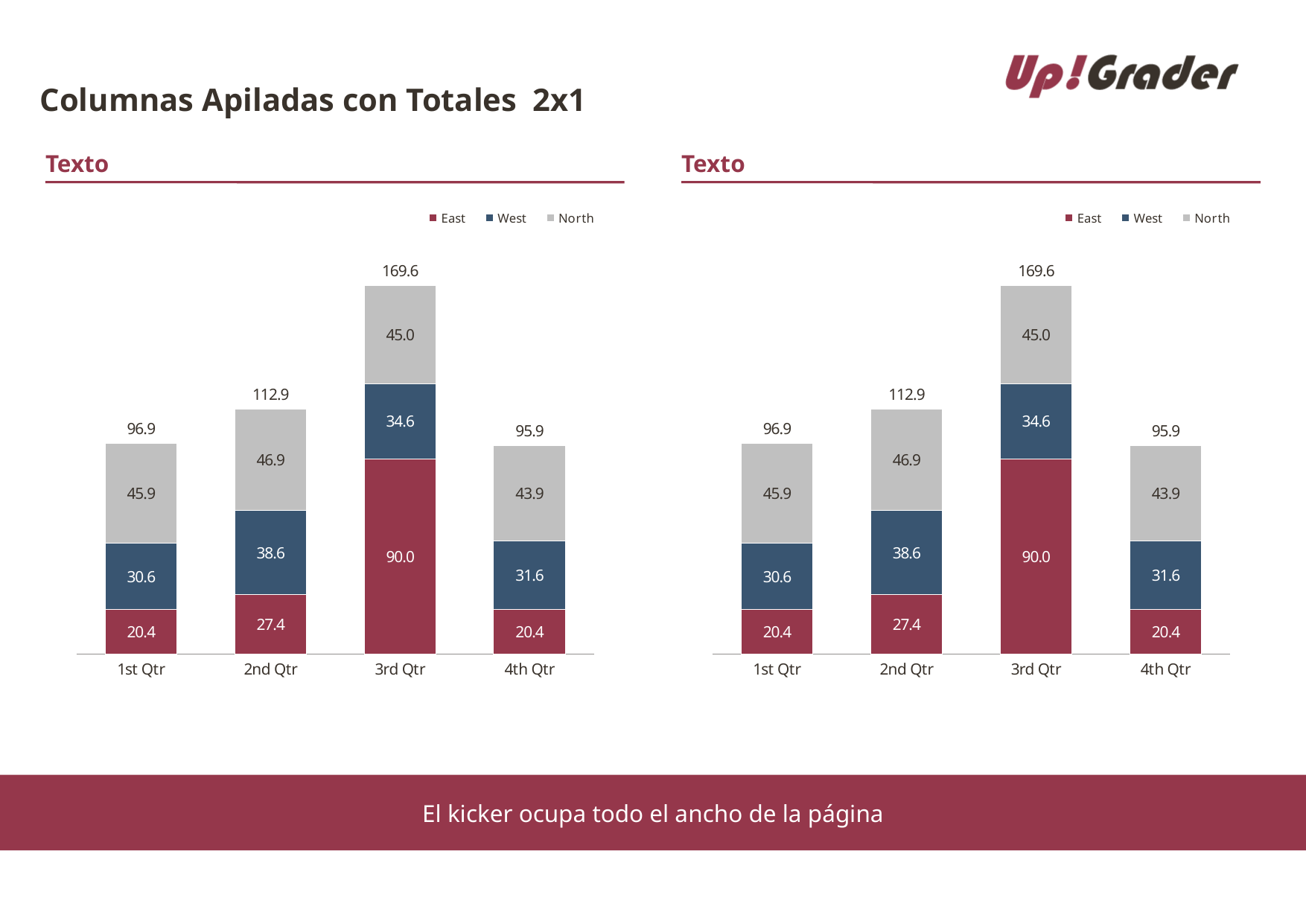
How many quarters are shown on the x axis of the left chart? 4 In the right chart, which is larger: the West value for 2nd Qtr or the West value for 4th Qtr? 2nd Qtr In the left chart, what is the East value for 2nd Qtr? 27.4 In the right chart, what is the total of the stacked bar for 2nd Qtr? 112.9 In the right chart, which quarter has the lowest stacked total? 4th Qtr In the left chart, what is the difference between the East values for 3rd Qtr and 1st Qtr? 69.6 In the left chart, which quarter has the highest stacked total? 3rd Qtr In the left chart, what is the West value for 3rd Qtr? 34.6 In the right chart, which series is shown in grey? North In the right chart, what is the North value for 4th Qtr? 43.9 How many series does the legend of the right chart list? 3 What kind of chart is the left chart? Stacked bar chart